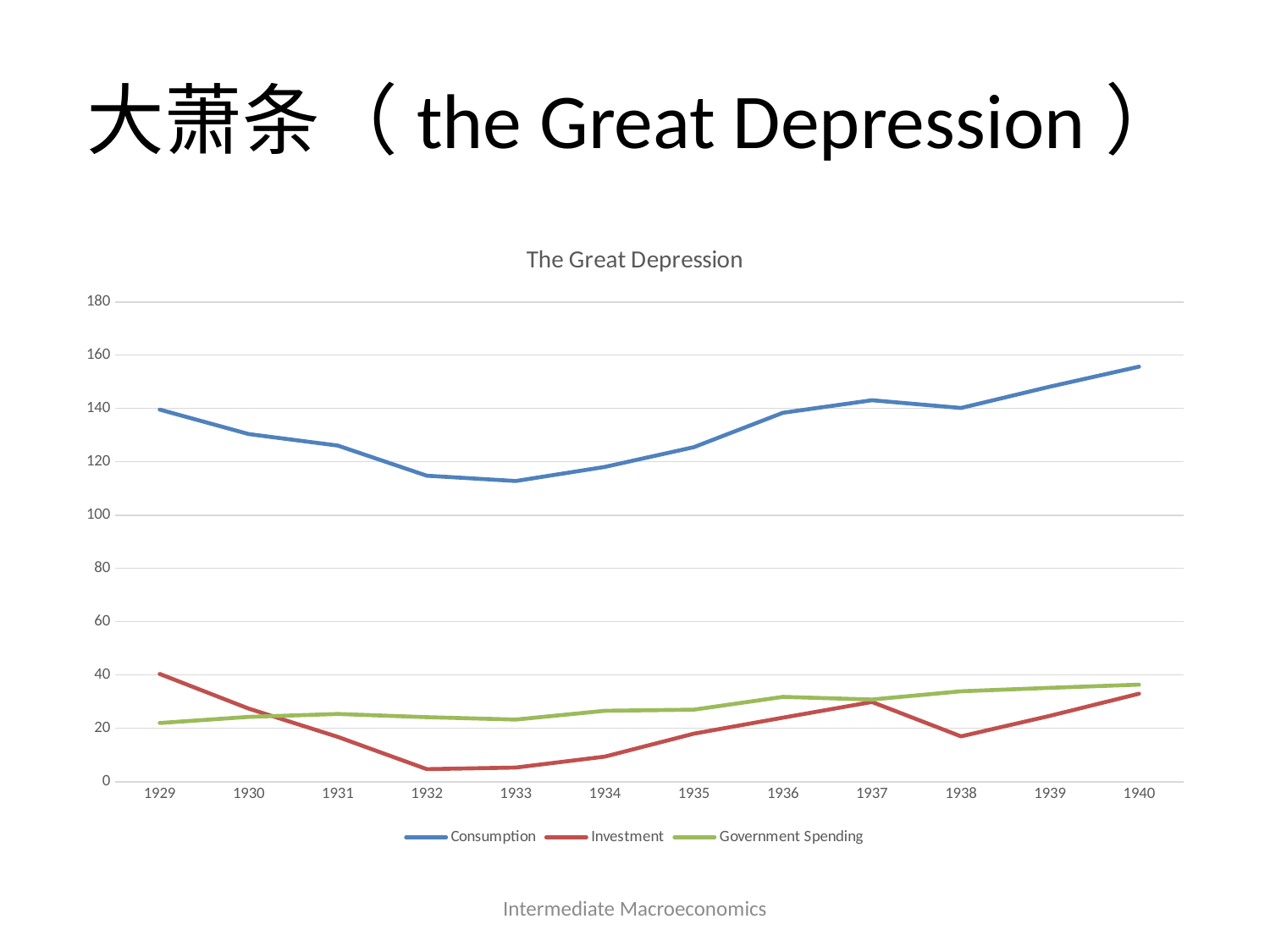
In 1938, which is larger: Investment or Government Spending? Government Spending In which year is Investment highest? 1929 Is the value for Investment in 1929 greater or less than 20? greater Does Consumption rise or fall from 1933 to 1940? rise How many years are shown on the x axis? 12 In which year is Consumption highest? 1940 Is the value for Investment in 1932 greater or less than 20? less How many series does the legend list? 3 What is the title of the chart? The Great Depression Is the value for Consumption in 1933 greater or less than 120? less What kind of chart is shown on the slide? line chart